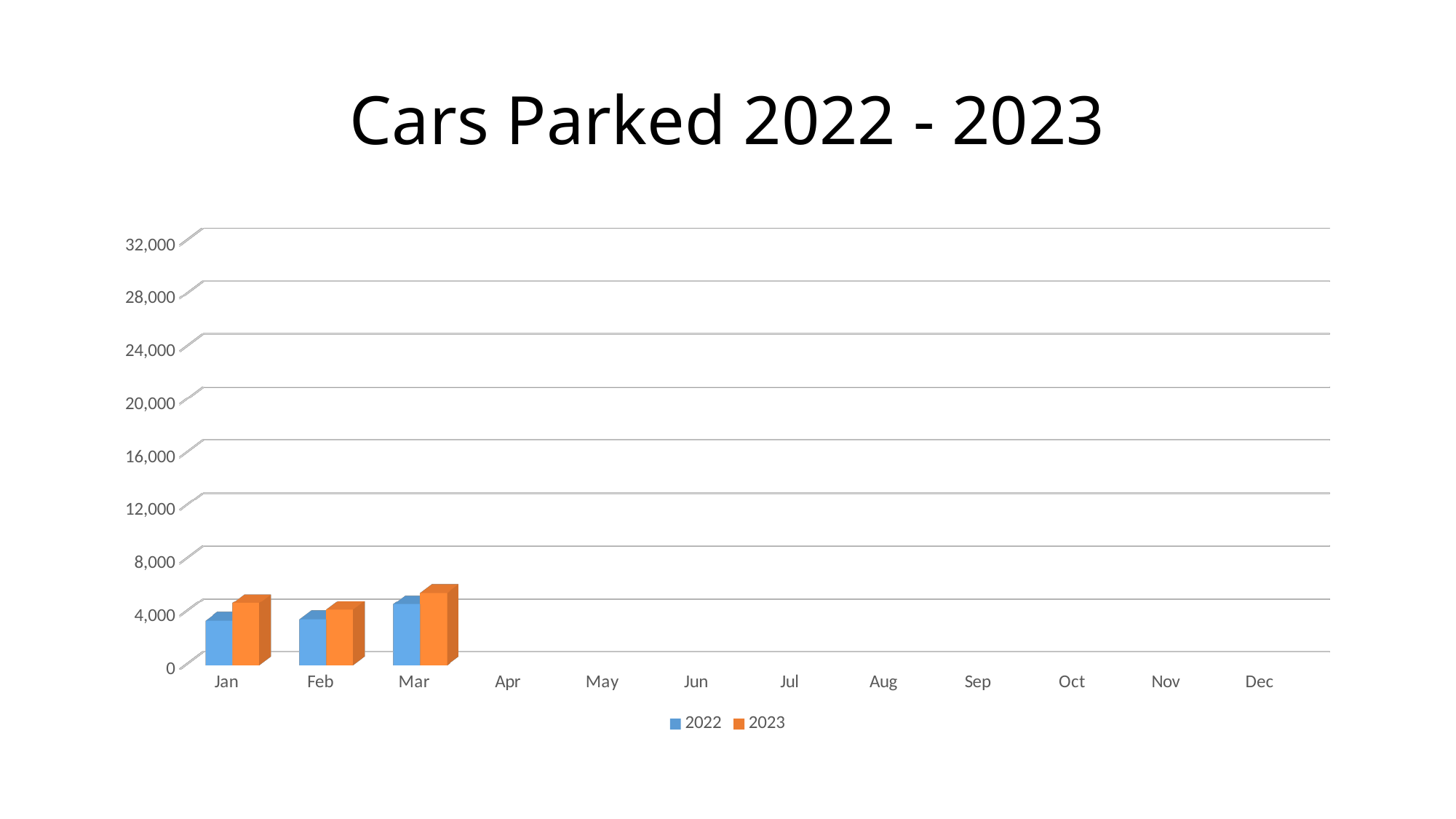
How many months are labelled along the x axis? 12 In Jan, which series has the larger value, 2022 or 2023? 2023 Do the 2022 values rise or fall from Jan to Mar? Rise Which colour represents the 2023 series? Orange Is the value for 2022 in Jan greater or less than 4,000? less Is the value for 2023 in Mar greater or less than 8,000? less What is the title of the chart? Cars Parked 2022 - 2023 What kind of chart is shown on the slide? Bar chart How many series does the legend list? 2 Which month has the highest value for the 2023 series? Mar How many months have bars plotted in the chart? 3 Is the value for 2023 in Mar greater or less than 4,000? greater